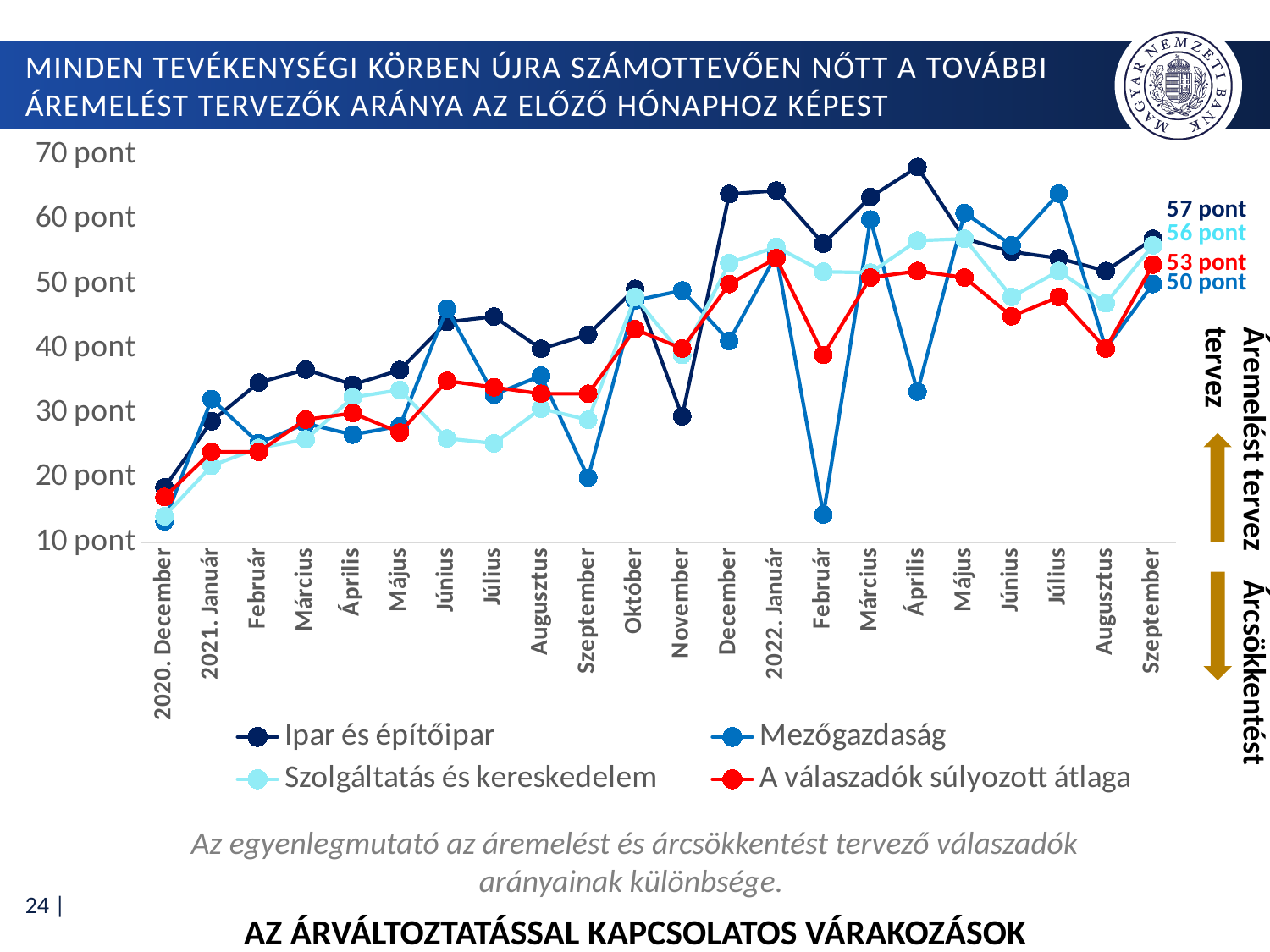
Does the Ipar és építőipar series generally rise or fall from 2020 December to 2022 Szeptember? rise Is the value for Mezőgazdaság in 2022 Február greater or less than 20 pont? less How many series does the legend list? 4 Is the value for Ipar és építőipar in 2022 Április greater or less than 60 pont? greater What is the value for Ipar és építőipar in 2022 Szeptember? 57 pont What is the value for A válaszadók súlyozott átlaga in 2022 Szeptember? 53 pont In 2022 Szeptember, which is larger: Szolgáltatás és kereskedelem or Mezőgazdaság? Szolgáltatás és kereskedelem What is the value for Szolgáltatás és kereskedelem in 2022 Szeptember? 56 pont What is the value for Mezőgazdaság in 2022 Szeptember? 50 pont Which series has the highest value in 2022 Szeptember? Ipar és építőipar What kind of chart is shown on the slide? line chart In 2022 Szeptember, what is the difference between Ipar és építőipar and Mezőgazdaság? 7 pont